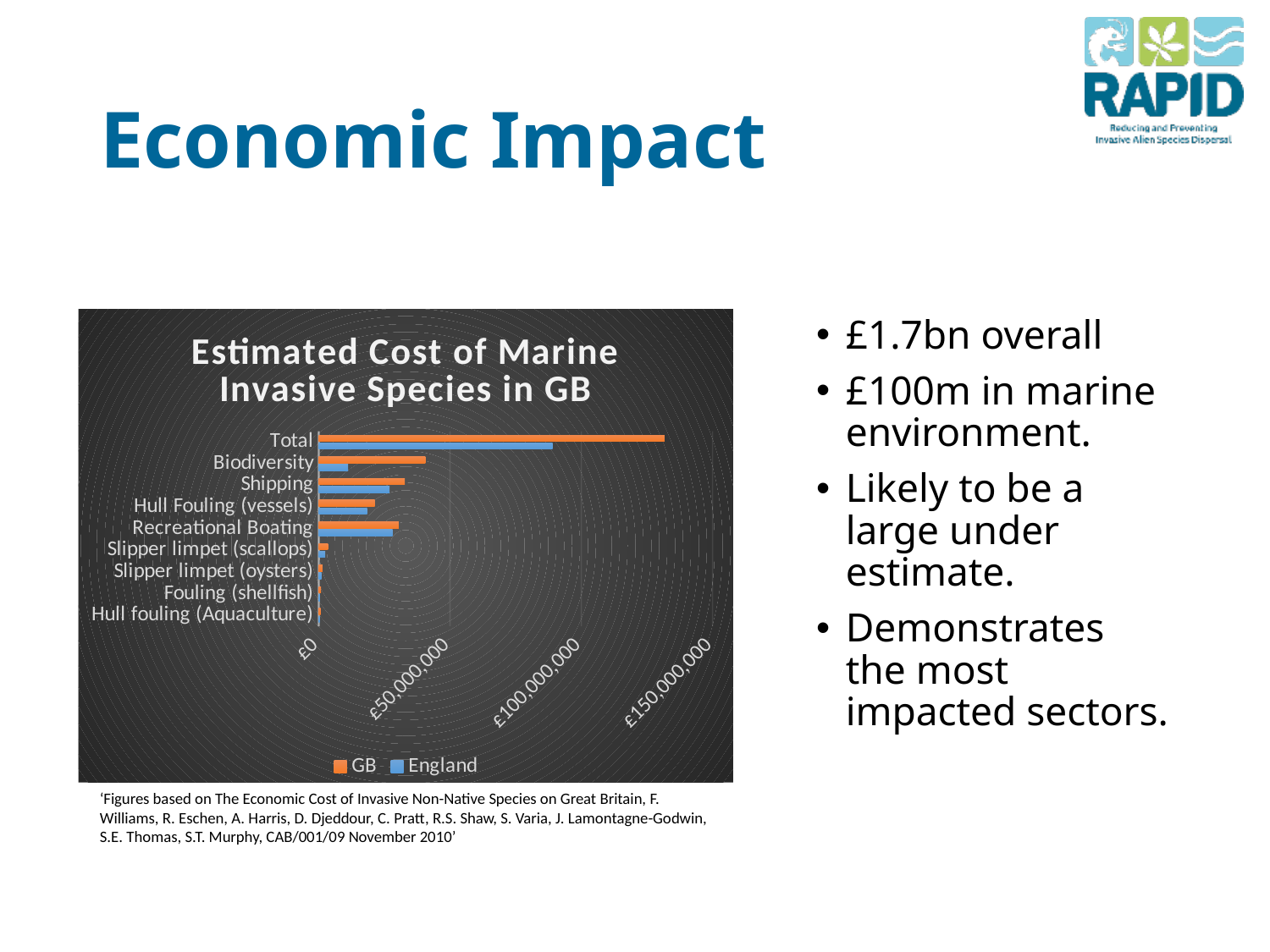
Which category has the highest GB value? Total For Biodiversity, which series has the larger value, GB or England? GB Is the GB value for Total greater or less than £100,000,000? greater Is the England value for Total greater or less than £100,000,000? less Is the GB value for Biodiversity greater or less than £50,000,000? less What is the title of the chart? Estimated Cost of Marine Invasive Species in GB How many categories are plotted on the chart? 9 Which colour represents the GB series in the chart? Orange For Total, which series has the larger value, GB or England? GB What kind of chart is shown on the slide? Bar chart Which has the larger GB value, Biodiversity or Shipping? Biodiversity How many series does the chart legend list? 2